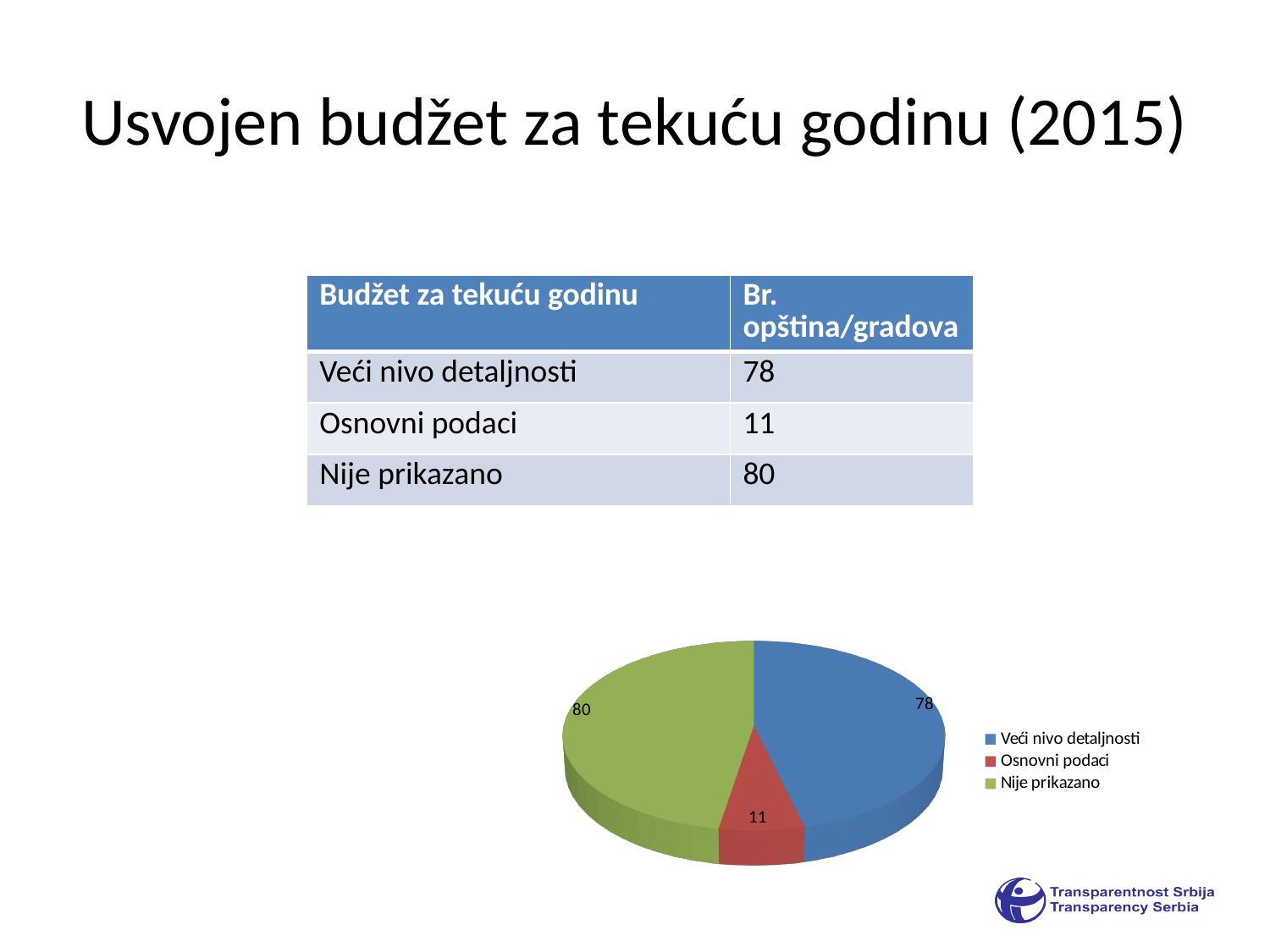
What is the value of the 'Veći nivo detaljnosti' slice in the pie chart? 78 What is the value of the 'Osnovni podaci' slice in the pie chart? 11 Which is larger in the pie chart: 'Veći nivo detaljnosti' or 'Osnovni podaci'? Veći nivo detaljnosti What is the value of the 'Nije prikazano' slice in the pie chart? 80 What kind of chart is shown on the slide? pie chart Which category has the largest slice in the pie chart? Nije prikazano Which category has the smallest slice in the pie chart? Osnovni podaci How many slices does the pie chart have? 3 What is the difference between the 'Veći nivo detaljnosti' and 'Osnovni podaci' values in the pie chart? 67 What is the difference between the 'Nije prikazano' and 'Veći nivo detaljnosti' values in the pie chart? 2 What colour is the 'Nije prikazano' slice in the pie chart? green How many entries does the legend of the pie chart list? 3